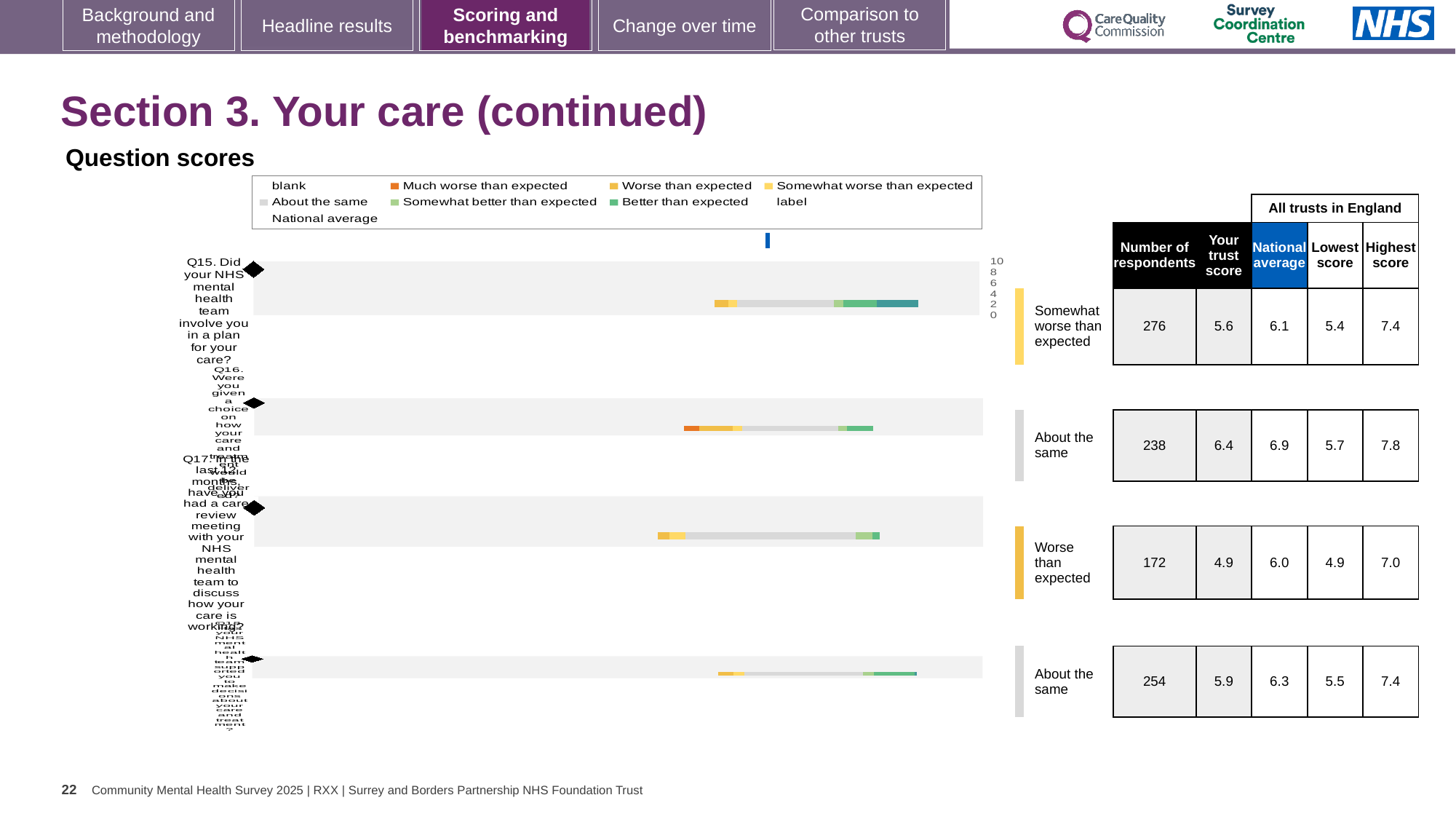
What is the number of respondents for Q15 (Did your NHS mental health team involve you in a plan for your care?)? 276 What is the national average for Q16 (Were you given a choice on how your care and treatment would be delivered?)? 6.9 How many entries does the legend of the question scores chart list? 9 Which has the larger trust score, Q15 or Q16? Q16 What is the highest score across all trusts in England for Q18? 7.4 What is the difference between the national average and the trust score for Q15? 0.5 What benchmark category is shown for Q17 (care review meeting)? Worse than expected How many question rows (Q15 to Q18) are plotted in the question scores chart? 4 Which question has the lowest trust score? Q17 Which question has the highest number of respondents? Q15 What is the trust score for Q17 (care review meeting with your NHS mental health team)? 4.9 What kind of chart is used to show the question scores on this slide? bar chart